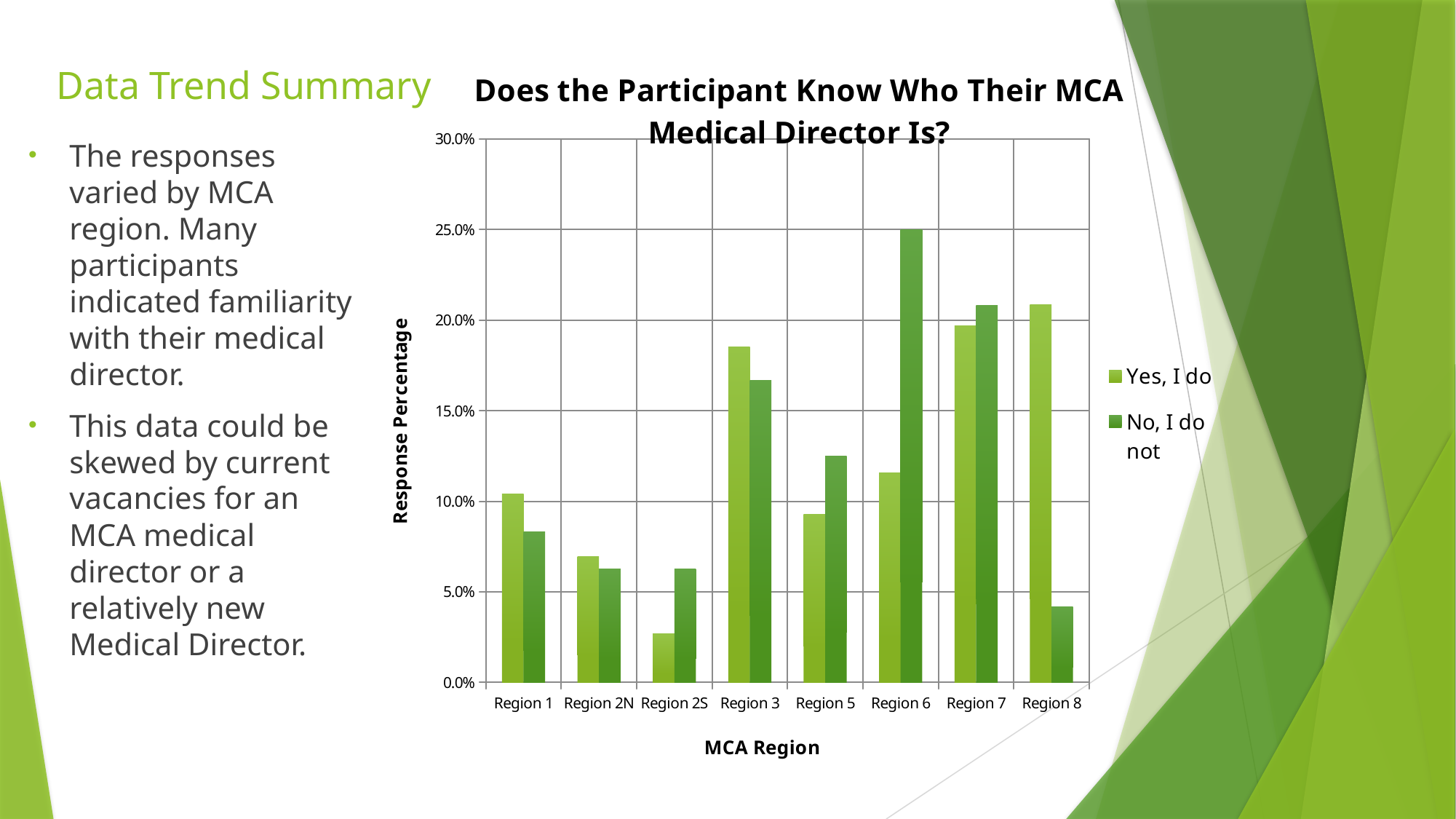
Is the "Yes, I do" value for Region 2S greater or less than 5.0%? less What kind of chart is shown on the slide? Bar chart For Region 8, which series has the larger value, "Yes, I do" or "No, I do not"? Yes, I do Which region has the highest value for the "No, I do not" series? Region 6 Is the "Yes, I do" value for Region 3 greater or less than 15.0%? greater How many series does the chart legend list? 2 What is the label of the chart's vertical axis? Response Percentage For Region 5, which series has the larger value, "Yes, I do" or "No, I do not"? No, I do not Which region has the lowest value for the "Yes, I do" series? Region 2S How many MCA regions are shown on the x axis of the chart? 8 Is the "No, I do not" value for Region 6 greater or less than 20.0%? greater Which region has the lowest value for the "No, I do not" series? Region 8